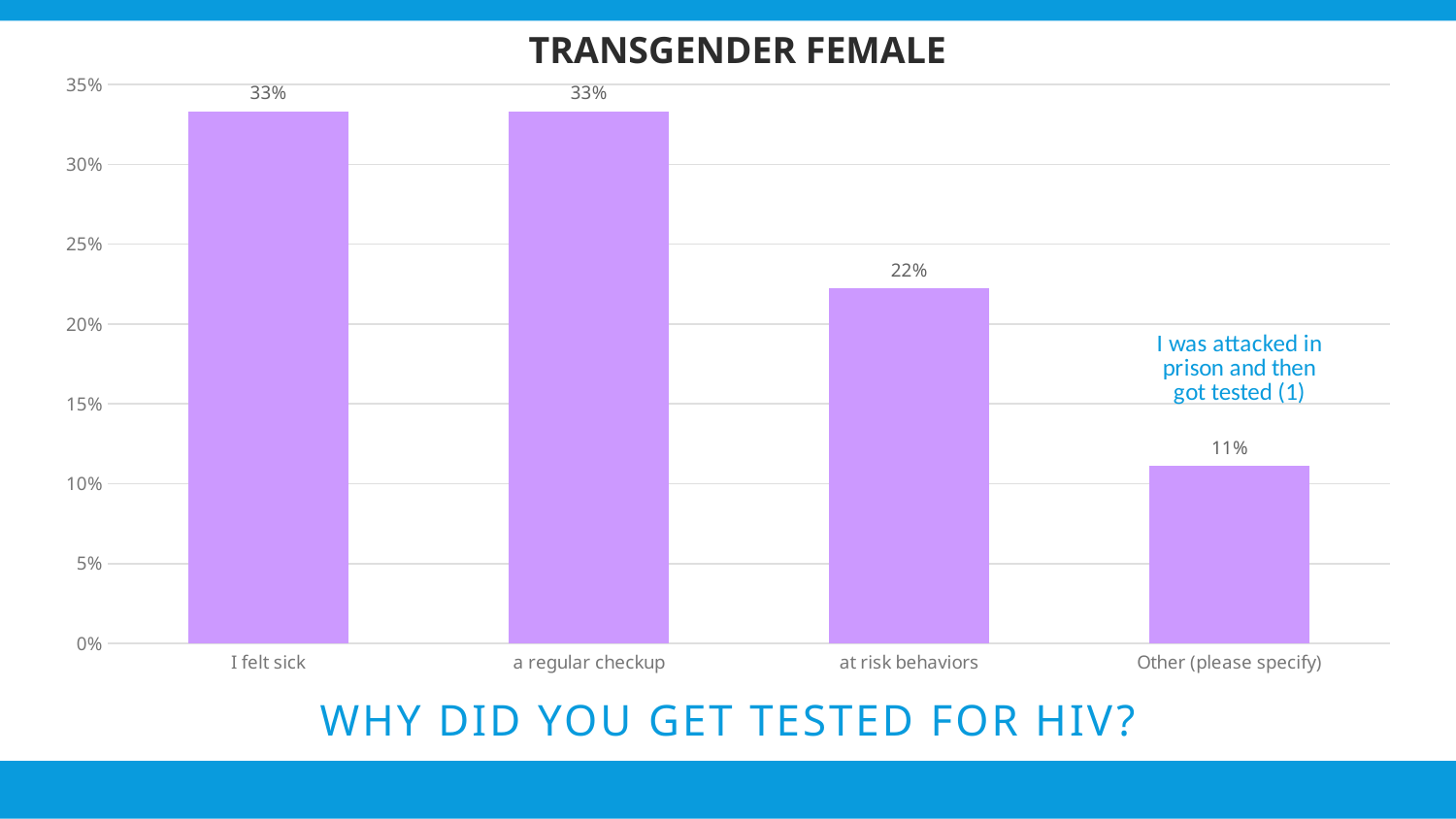
How many categories are shown on the x axis? 4 What is the value for "a regular checkup"? 33% What is the value for "at risk behaviors"? 22% Which category has the lowest value? Other (please specify) What is the difference between the values for "at risk behaviors" and "Other (please specify)"? 11% What is the title of the chart? TRANSGENDER FEMALE Is the value for "at risk behaviors" greater or less than 20%? greater What kind of chart is shown on the slide? bar chart Which is larger, the value for "a regular checkup" or the value for "at risk behaviors"? a regular checkup What is the value for "Other (please specify)"? 11% What is the value for "I felt sick"? 33% What is the difference between the values for "I felt sick" and "at risk behaviors"? 11%